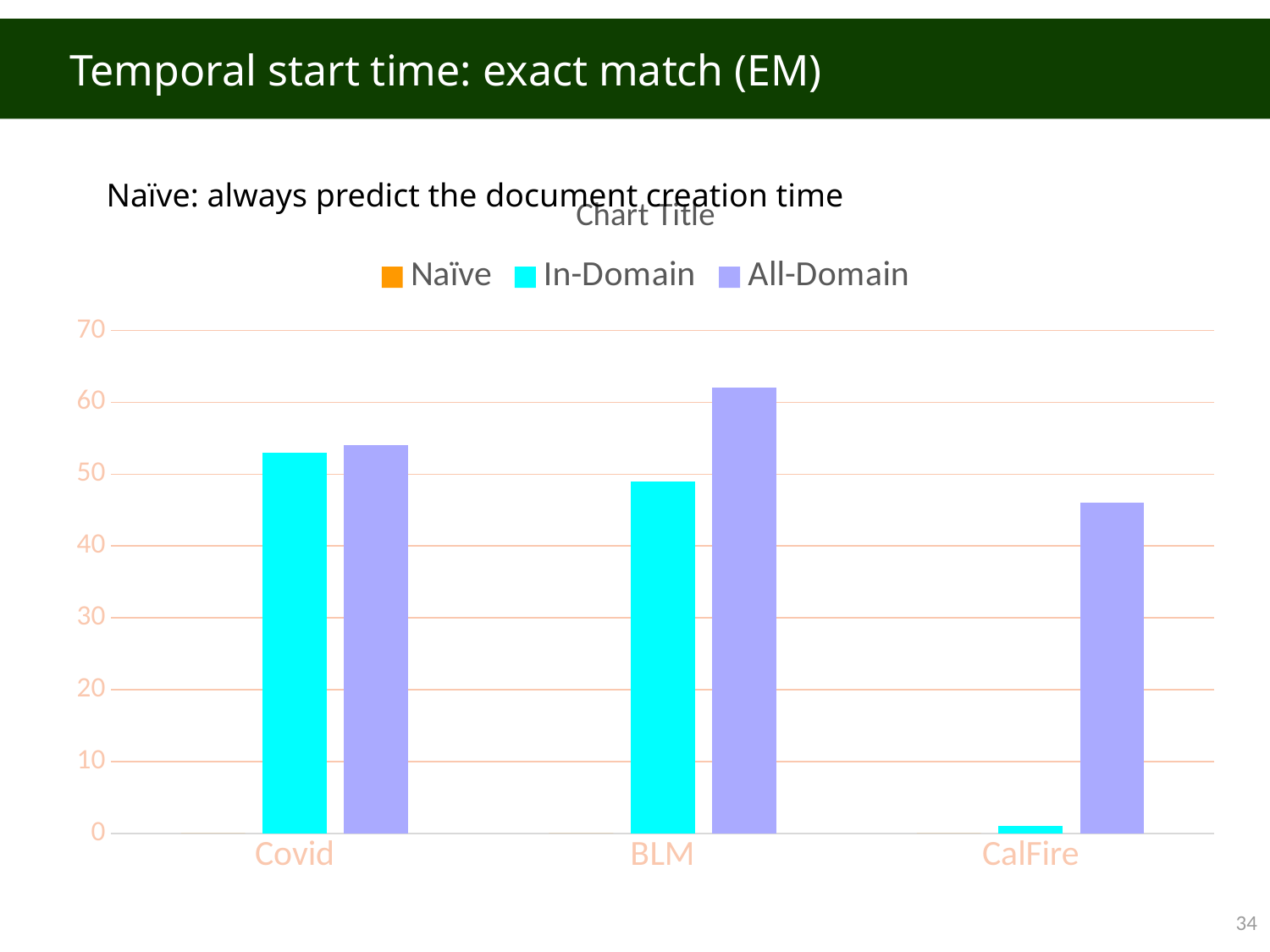
For BLM, which is larger: the In-Domain value or the All-Domain value? All-Domain Which category has the highest All-Domain value? BLM Which series is shown in cyan in the chart legend? In-Domain Which category has the lowest All-Domain value? CalFire What kind of chart is shown on the slide? bar chart How many series does the chart legend list? 3 Is the In-Domain value for CalFire greater or less than 10? less How many categories are shown on the x axis of the chart? 3 For CalFire, which is larger: the In-Domain value or the All-Domain value? All-Domain Which category has the highest In-Domain value? Covid Is the All-Domain value for CalFire greater or less than 50? less Which category has the lowest In-Domain value? CalFire